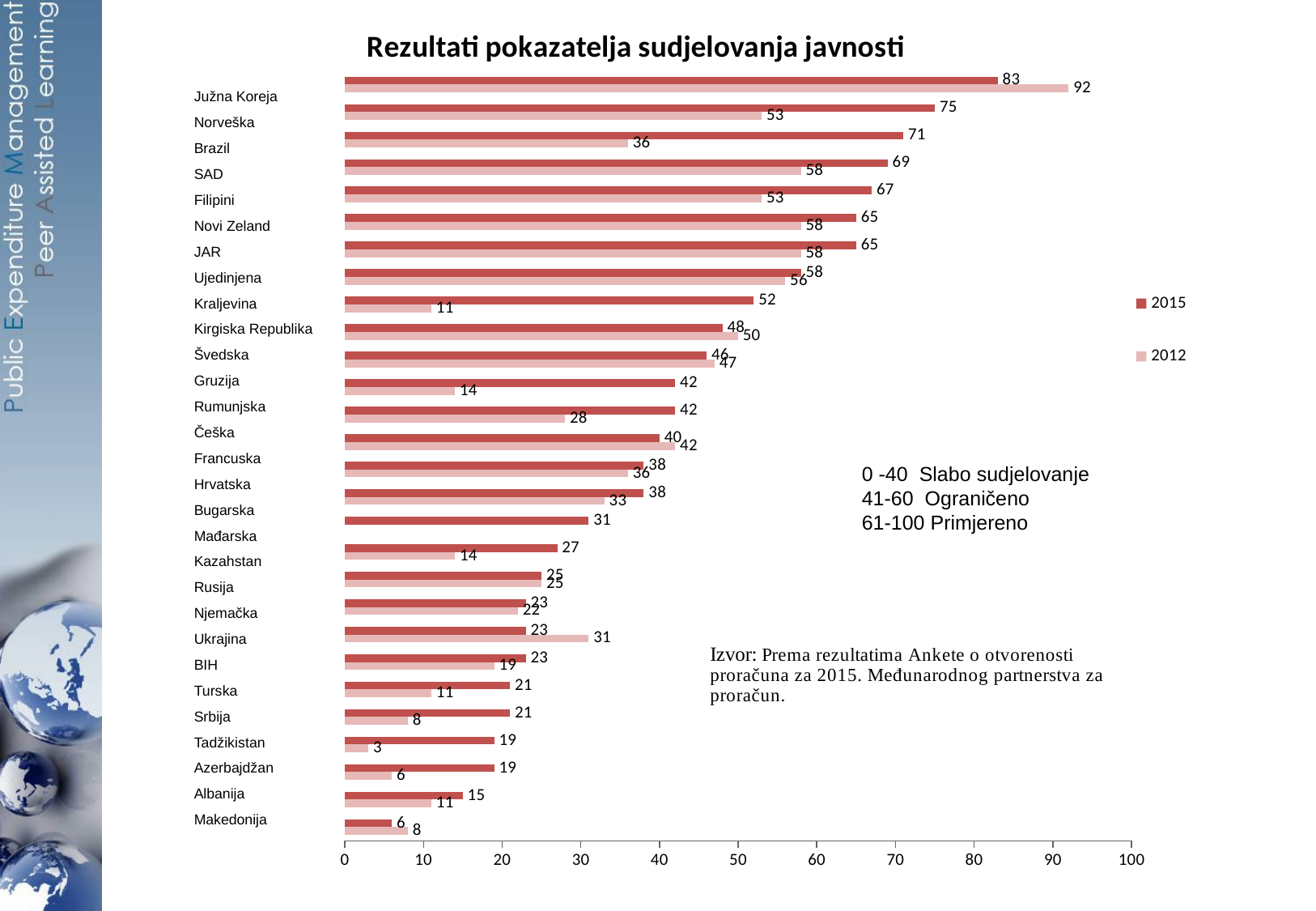
What kind of chart is shown on the slide? bar chart How many series does the legend list? 2 What is the difference between the 2015 and 2012 values for Srbija? 13 What is the 2012 value for Norveška? 53 What are the two entries in the legend? 2015 and 2012 What is the 2012 value for Južna Koreja? 92 What is the 2015 value for Makedonija? 6 Which country has the highest 2015 value? Južna Koreja What is the difference between the 2015 and 2012 values for Brazil? 35 Which country has the lowest 2012 value? Tadžikistan Which has the larger 2015 value, Norveška or Brazil? Norveška What is the 2015 value for Južna Koreja? 83